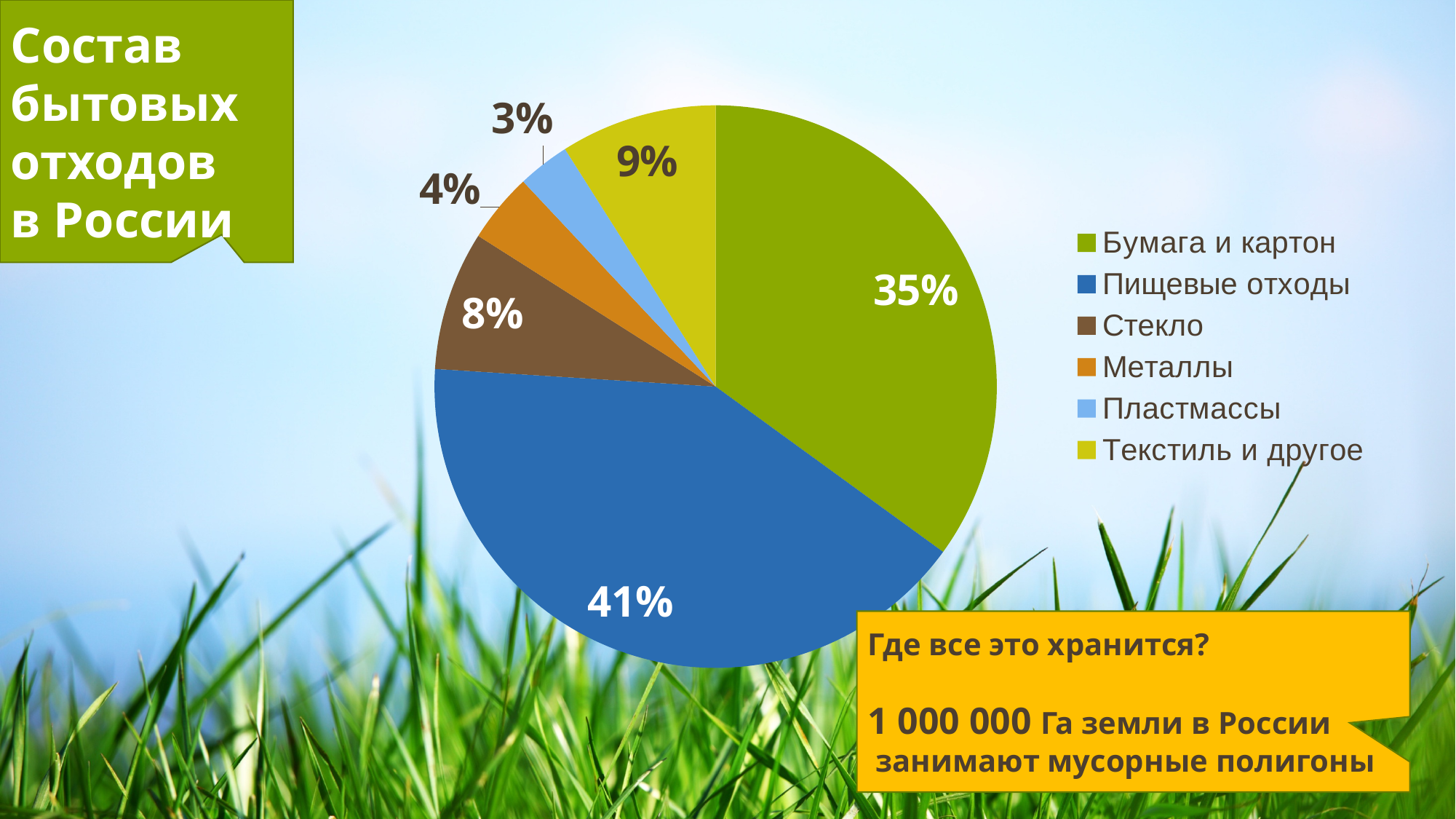
How many categories does the pie chart show? 6 Which is larger, the share for Текстиль и другое or the share for Стекло? Текстиль и другое Which category has the largest slice of the pie? Пищевые отходы What share of the pie does Бумага и картон take? 35% Which category has the smallest slice of the pie? Пластмассы What share of the pie does Стекло take? 8% What is the difference in percentage points between Пищевые отходы and Бумага и картон? 6 What share of the pie does Пластмассы take? 3% What is the combined share of Металлы and Пластмассы? 7% What share of the pie does Пищевые отходы take? 41% Which legend entry is shown in blue? Пищевые отходы What kind of chart is shown on the slide? Pie chart